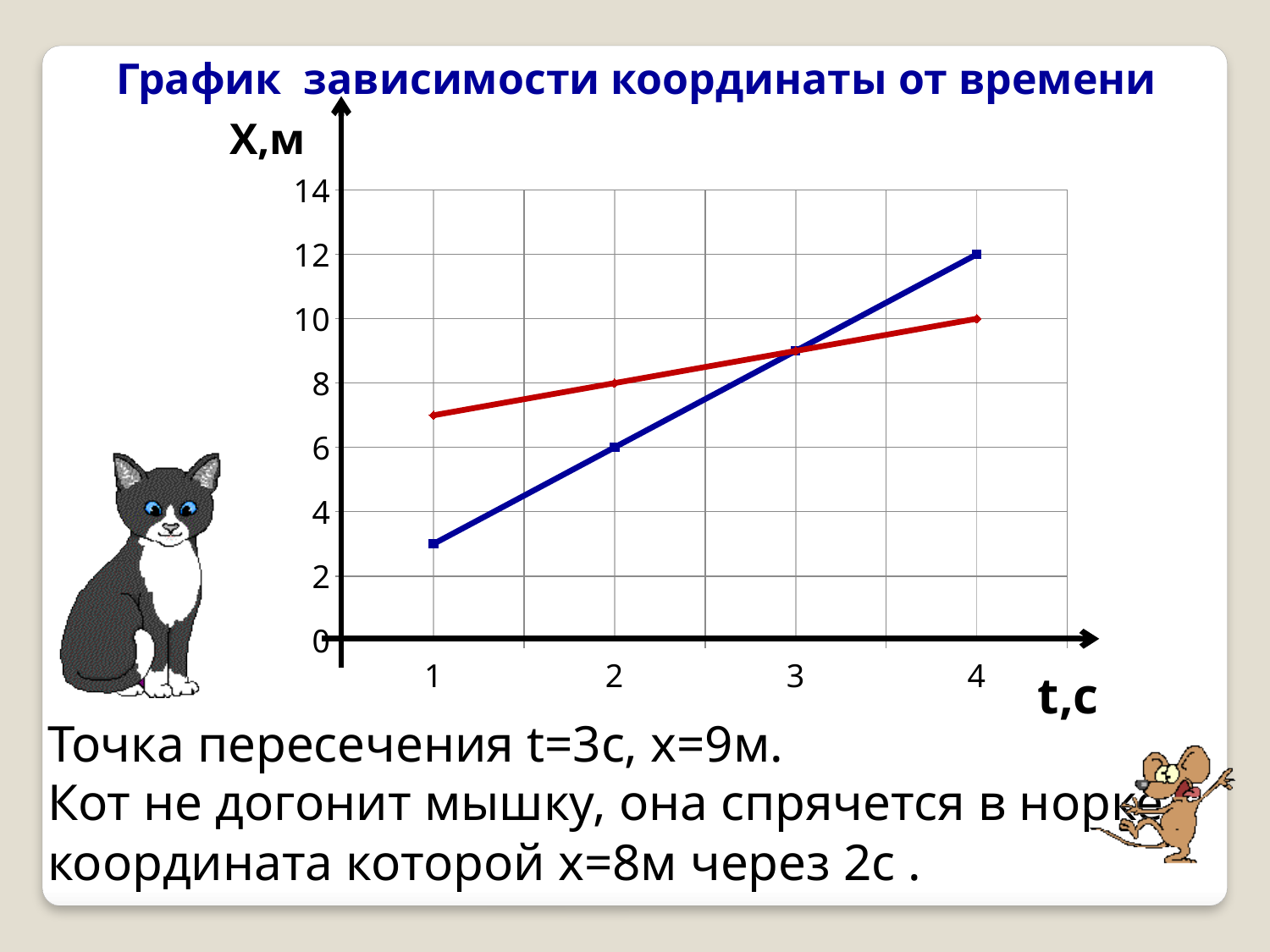
At what time and coordinate do the two lines intersect? t=3с, x=9м What are the labels of the vertical and horizontal axes? X,м and t,с What is the value of the blue line at t=2? 6 What is the difference between the blue and red line values at t=4? 2 How many lines are plotted on the chart? 2 What is the title of the chart? График зависимости координаты от времени What is the value of the red line at t=2? 8 Which line has the higher value at t=1, the blue or the red? Red What is the value of the red line at t=4? 10 What is the value of the blue line at t=4? 12 What kind of chart is shown on the slide? Line chart Is the value of the blue line at t=1 greater or less than 4? less